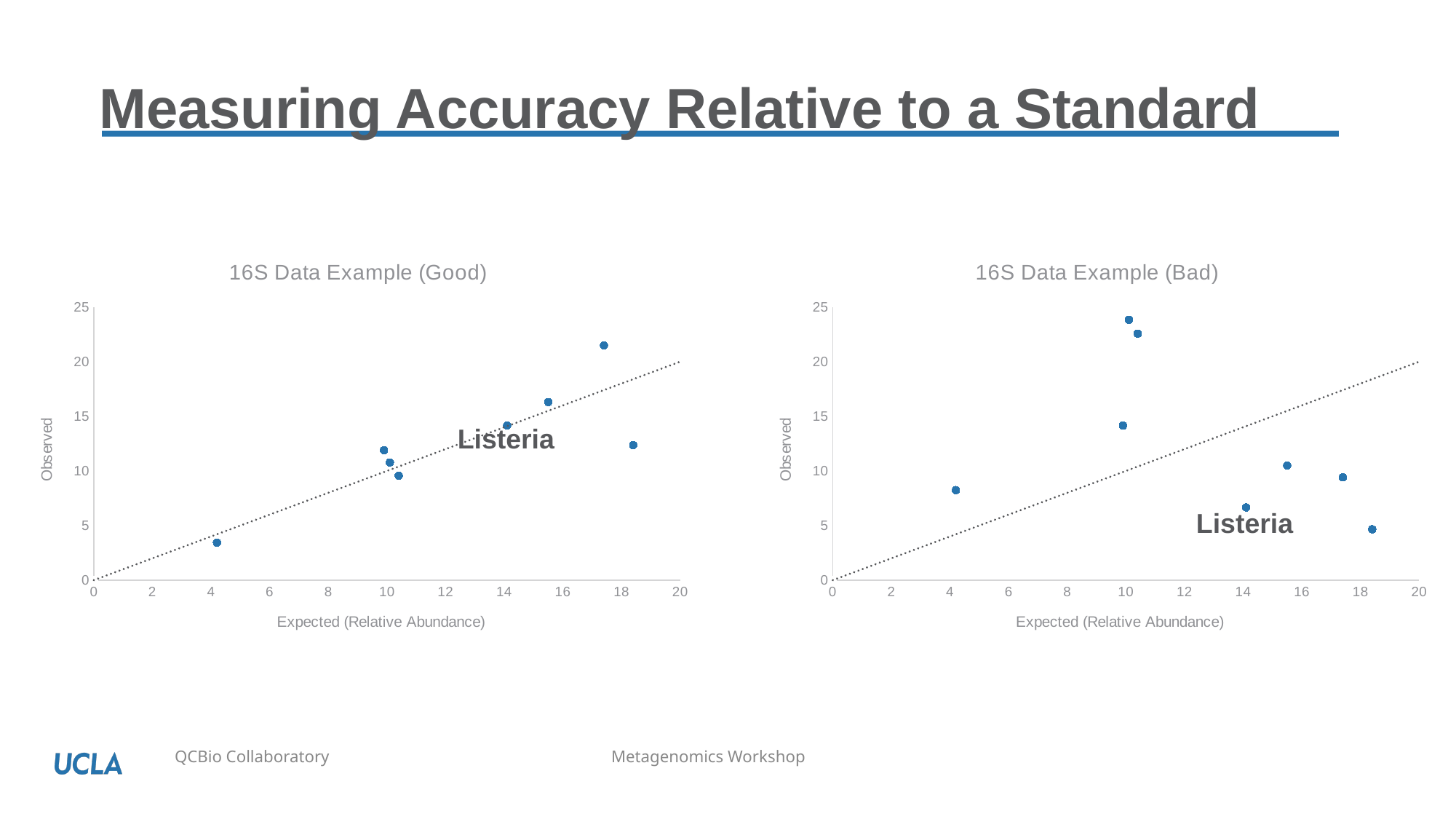
What is the x-axis label of the "16S Data Example (Good)" chart? Expected (Relative Abundance) In the "16S Data Example (Bad)" chart, is the observed value of the point with the lowest expected value greater or less than 5? greater What kind of chart is the "16S Data Example (Good)" chart? scatter chart How many data points are plotted in the "16S Data Example (Good)" chart? 8 In the "16S Data Example (Good)" chart, is the observed value of the point with the lowest expected value greater or less than 5? less Which chart has the higher maximum observed value, "16S Data Example (Good)" or "16S Data Example (Bad)"? 16S Data Example (Bad) In the "16S Data Example (Bad)" chart, is the highest observed value greater or less than 20? greater How many data points are plotted in the "16S Data Example (Bad)" chart? 8 What is the y-axis label of the "16S Data Example (Bad)" chart? Observed What kind of chart is the "16S Data Example (Bad)" chart? scatter chart